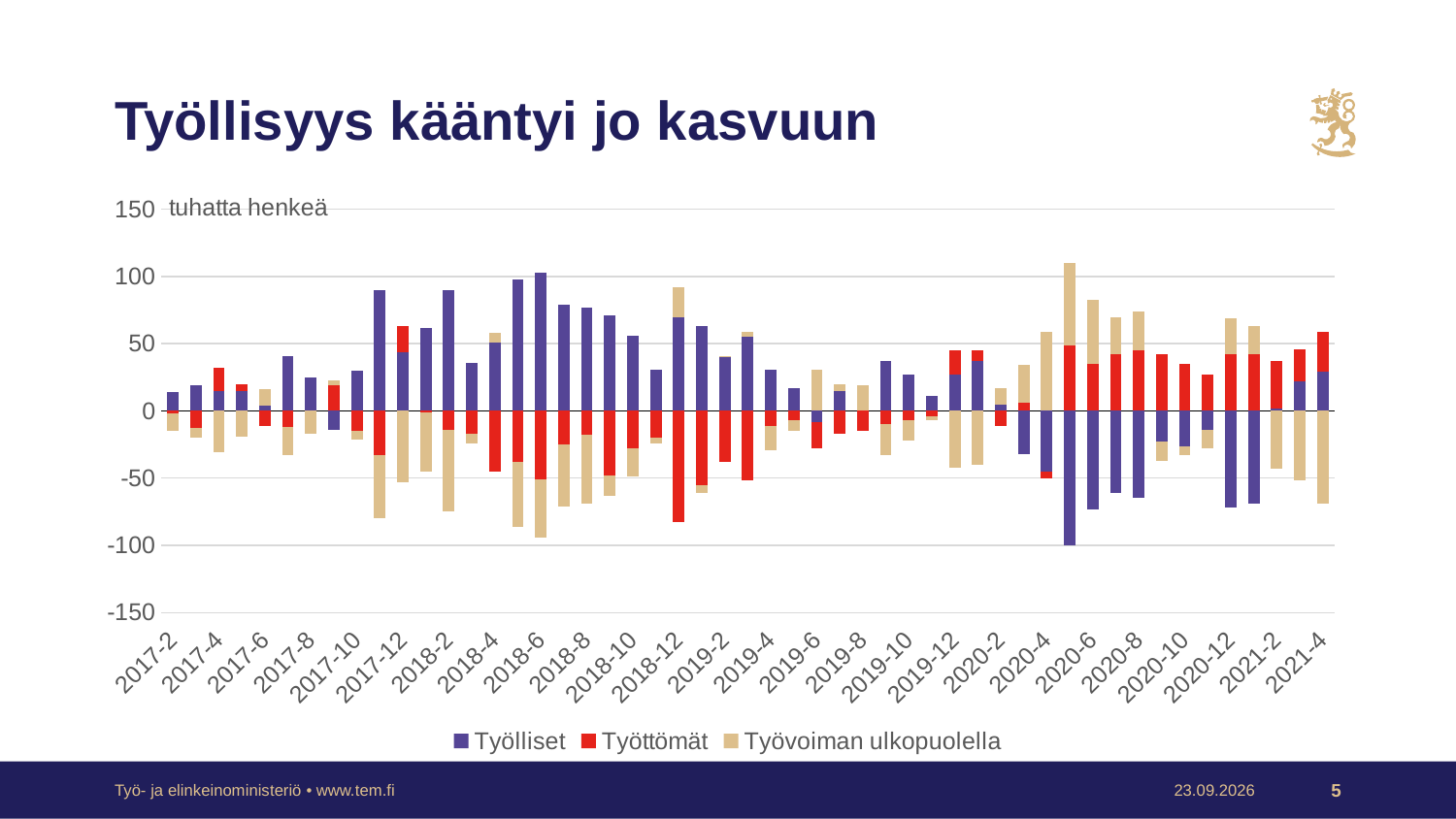
Which series is shown in red in the legend? Työttömät What is the title of the slide? Työllisyys kääntyi jo kasvuun What is the last category label on the x axis? 2021-4 Is the value for Työlliset in 2017-2 greater or less than 50? less What unit label is shown at the top of the vertical axis? tuhatta henkeä How many series does the legend list? 3 What is the first category label on the x axis? 2017-2 Is the value for Työvoiman ulkopuolella in 2021-4 greater or less than -50? less What kind of chart is shown on the slide? Stacked bar chart What is the highest value shown on the vertical axis? 150 Is the value for Työlliset in 2018-6 greater or less than 50? greater Does the Työlliset value rise or fall between 2018-6 and 2019-6? fall